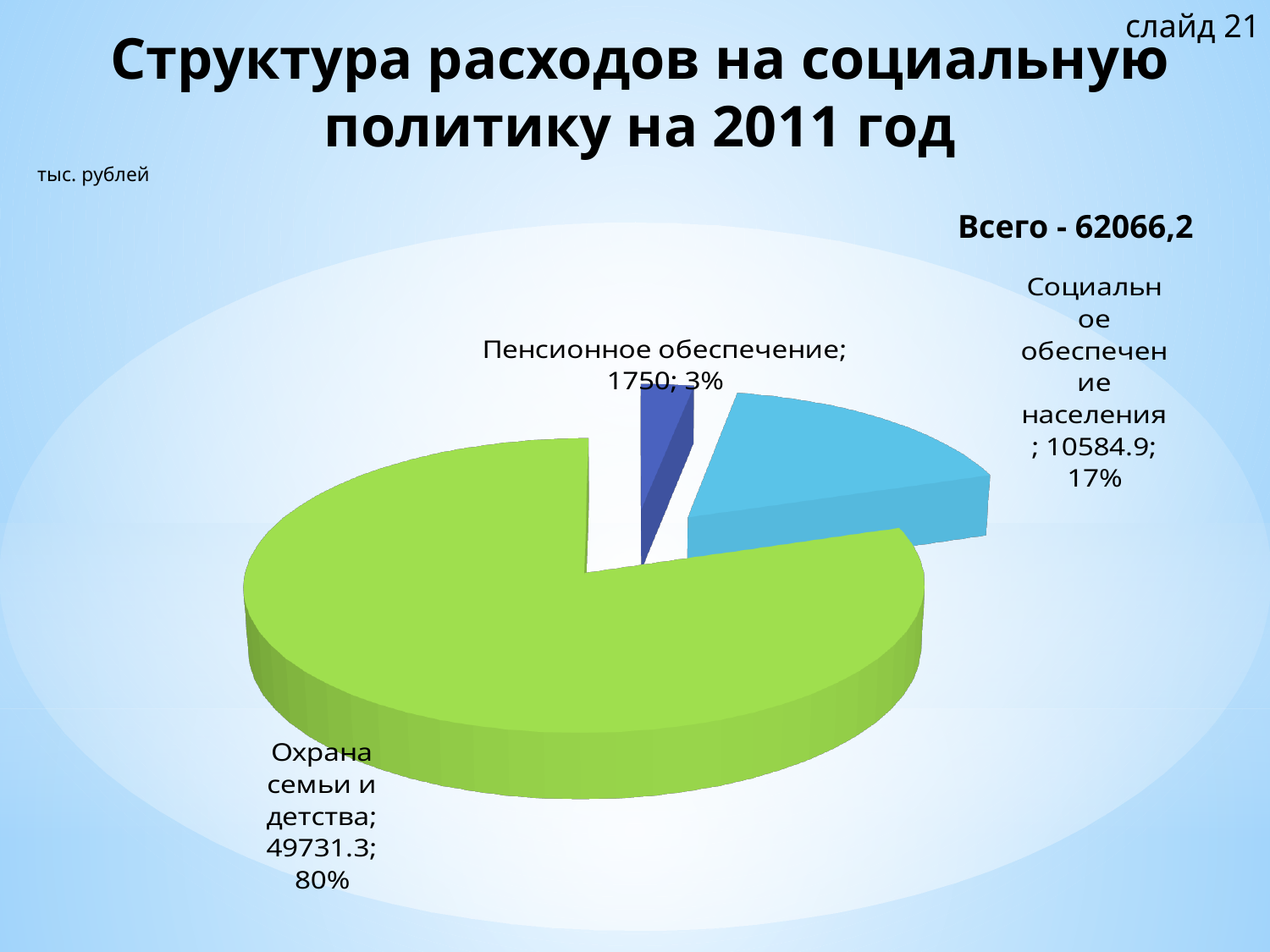
What is the value for Социальное обеспечение населения? 10584.9 What is the value for Охрана семьи и детства? 49731.3 What share of the pie does Пенсионное обеспечение represent? 3% Which category has the smallest slice? Пенсионное обеспечение What is the value for Пенсионное обеспечение? 1750 How many slices does the pie chart have? 3 Which category has the largest slice? Охрана семьи и детства What total (Всего) is stated on the slide? 62066,2 What share of the pie does Охрана семьи и детства represent? 80% What type of chart is shown on the slide? Pie chart Which is larger, Социальное обеспечение населения or Пенсионное обеспечение? Социальное обеспечение населения What share of the pie does Социальное обеспечение населения represent? 17%